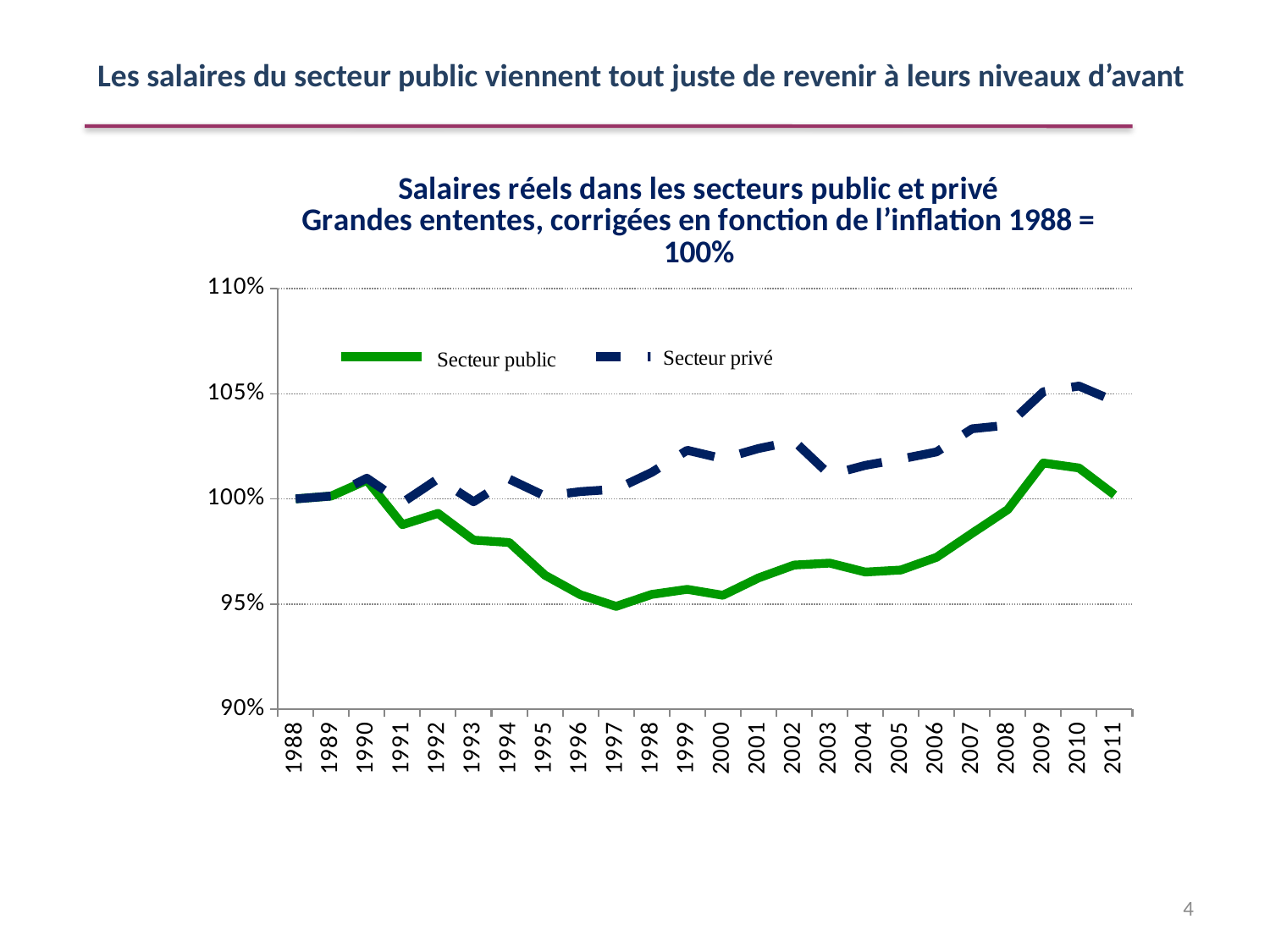
What is the value of Secteur public in 1988? 100% Is the value for Secteur public in 1995 greater or less than 95%? greater How many years are plotted along the x axis? 24 What kind of chart is shown on the slide? line chart Which series is drawn with a dashed line? Secteur privé How many series does the legend list? 2 Does the Secteur public line rise or fall between 1990 and 1997? fall In which year is the Secteur public line at its lowest? 1997 Is the value for Secteur privé in 2007 greater or less than 100%? greater Is the value for Secteur public in 2005 greater or less than 100%? less In 2005, which series has the higher value, Secteur public or Secteur privé? Secteur privé In which year is the Secteur public line at its highest? 2009